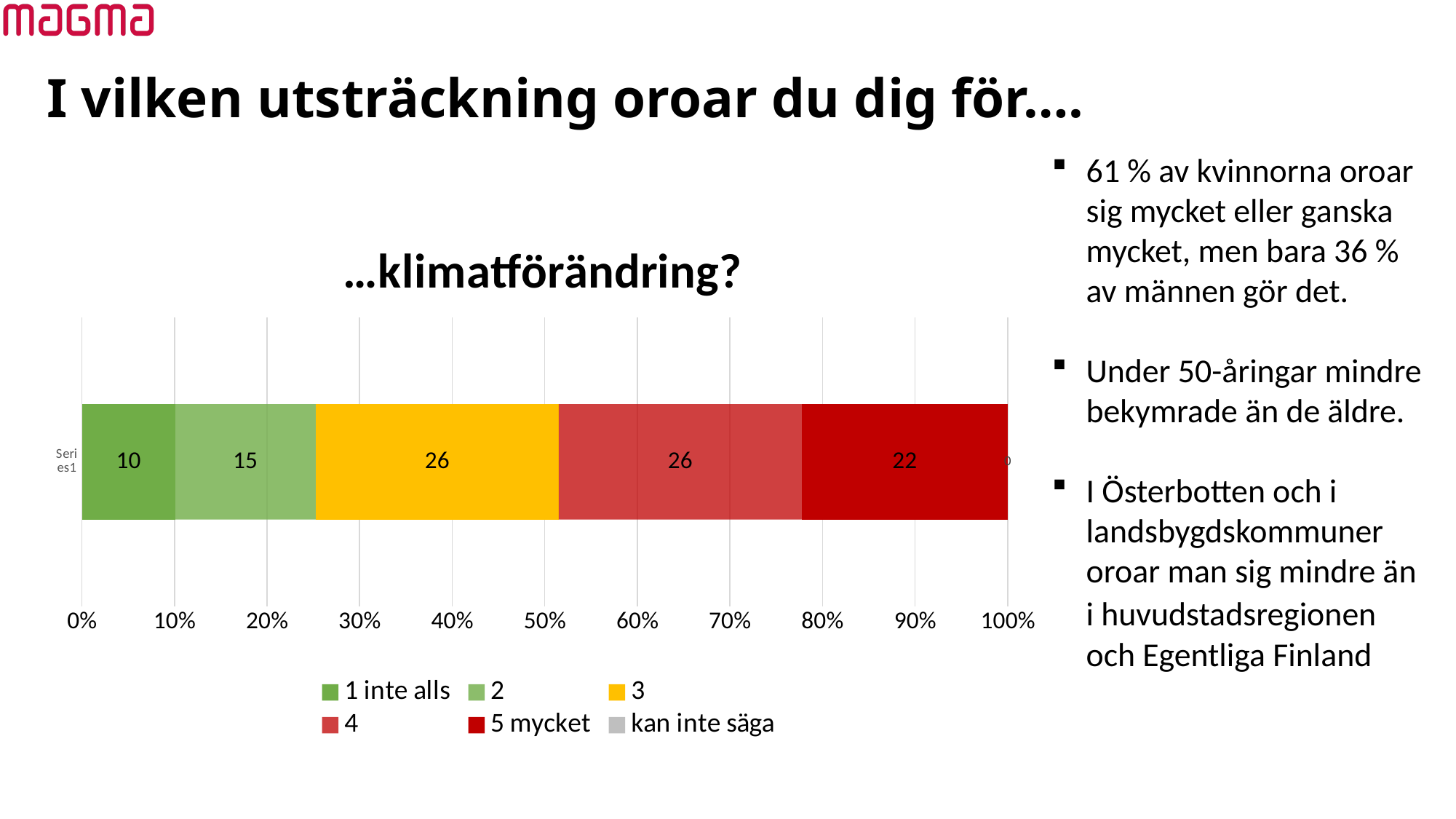
What is the title of the chart? …klimatförändring? What value is shown for the "1 inte alls" segment of the bar? 10 What value is shown for the "5 mycket" segment of the bar? 22 Which is larger, the "2" segment or the "5 mycket" segment? 5 mycket What colour is the "5 mycket" segment in the chart? Dark red What value is shown for the "3" segment of the bar? 26 What is the combined value of the "4" and "5 mycket" segments? 48 How many series does the legend list? 6 What is the difference between the "5 mycket" segment and the "1 inte alls" segment? 12 What kind of chart is shown on the slide? Stacked bar chart What value is shown for the "2" segment of the bar? 15 Which segment has the smallest value among those with a printed label? 1 inte alls